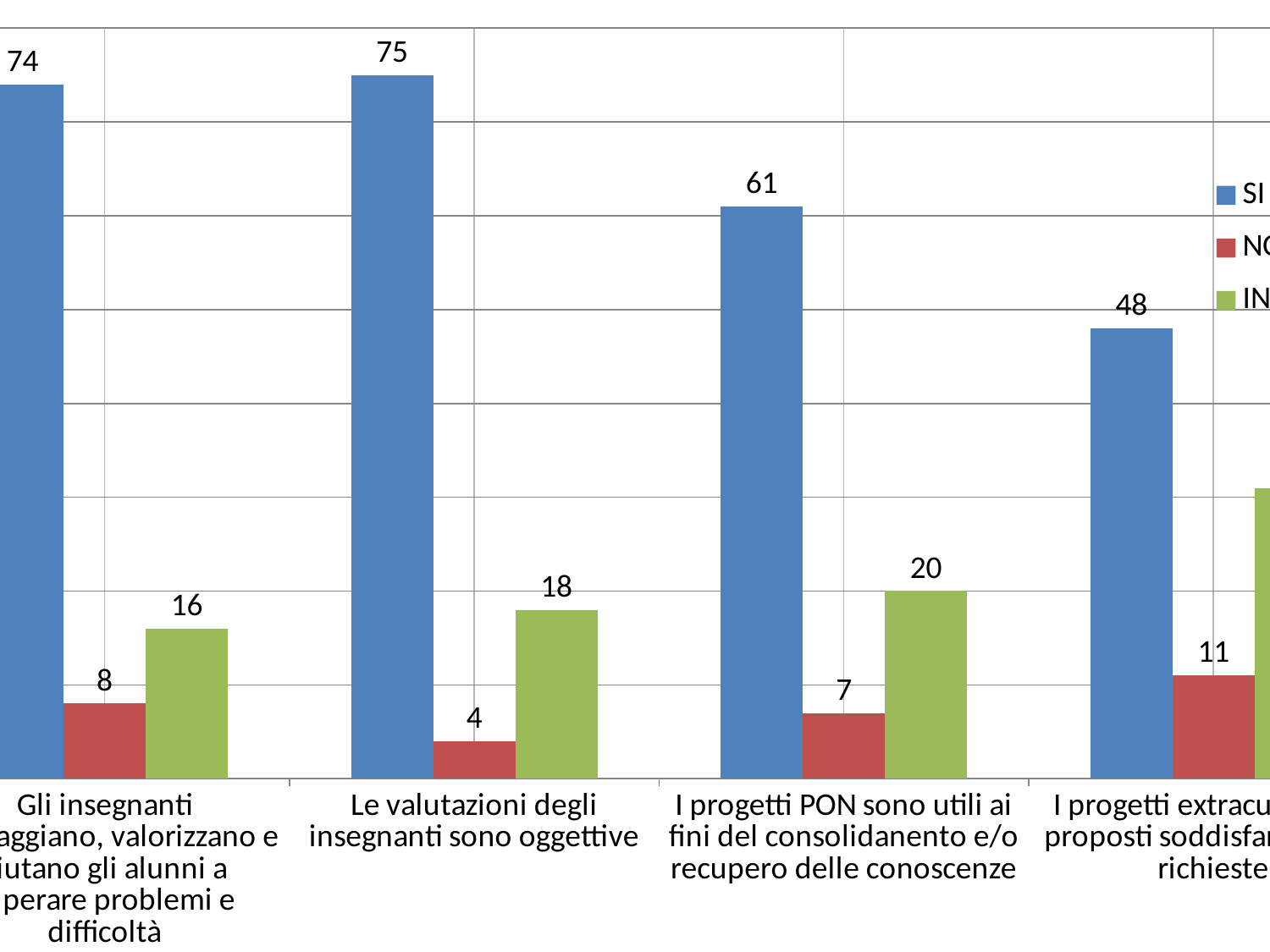
How many category groups are shown on the chart? 4 Which has the larger red bar value: "Le valutazioni degli insegnanti sono oggettive" or "I progetti PON sono utili ai fini del consolidanento e/o recupero delle conoscenze"? I progetti PON sono utili ai fini del consolidanento e/o recupero delle conoscenze What is the difference between the green bar values for "I progetti PON sono utili ai fini del consolidanento e/o recupero delle conoscenze" and "Le valutazioni degli insegnanti sono oggettive"? 2 What is the difference between the SI value and the green bar value for "I progetti PON sono utili ai fini del consolidanento e/o recupero delle conoscenze"? 41 What is the value of the SI series for "I progetti PON sono utili ai fini del consolidanento e/o recupero delle conoscenze"? 61 What kind of chart is shown on the slide? Bar chart What is the value of the red bar for "Le valutazioni degli insegnanti sono oggettive"? 4 What colour represents the SI series? Blue How many series does the legend list? 3 Which category has the highest SI value? Le valutazioni degli insegnanti sono oggettive What is the value of the green bar for "I progetti PON sono utili ai fini del consolidanento e/o recupero delle conoscenze"? 20 What is the value of the SI series for "Le valutazioni degli insegnanti sono oggettive"? 75